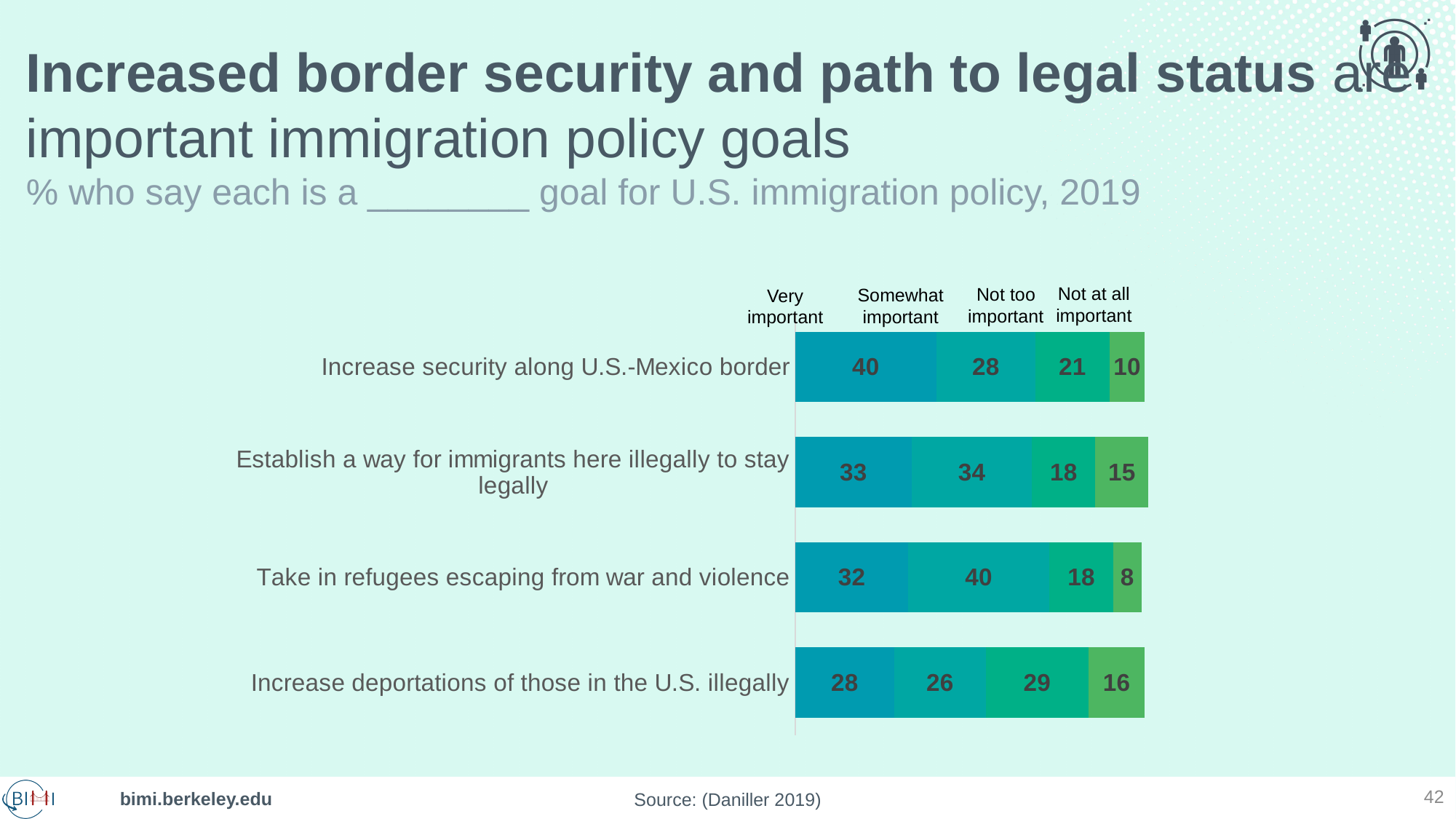
What percentage say increasing deportations of those in the U.S. illegally is not too important? 29 What is the difference between the very important shares for increasing border security and increasing deportations? 12 What is the source cited for the chart? Daniller 2019 What percentage say increasing security along the U.S.-Mexico border is a very important goal? 40 Which goal has the lowest share saying it is not at all important? Take in refugees escaping from war and violence How many response categories (series) does the chart show? 4 What percentage say taking in refugees escaping from war and violence is a somewhat important goal? 40 What is the total of the four values for 'Establish a way for immigrants here illegally to stay legally'? 100 How many immigration policy goals are shown in the chart? 4 Which is larger: the not at all important share for establishing a way for immigrants here illegally to stay legally, or for increasing border security? Establish a way for immigrants here illegally to stay legally What type of chart is shown on the slide? Stacked bar chart Which goal has the highest share saying it is very important? Increase security along U.S.-Mexico border